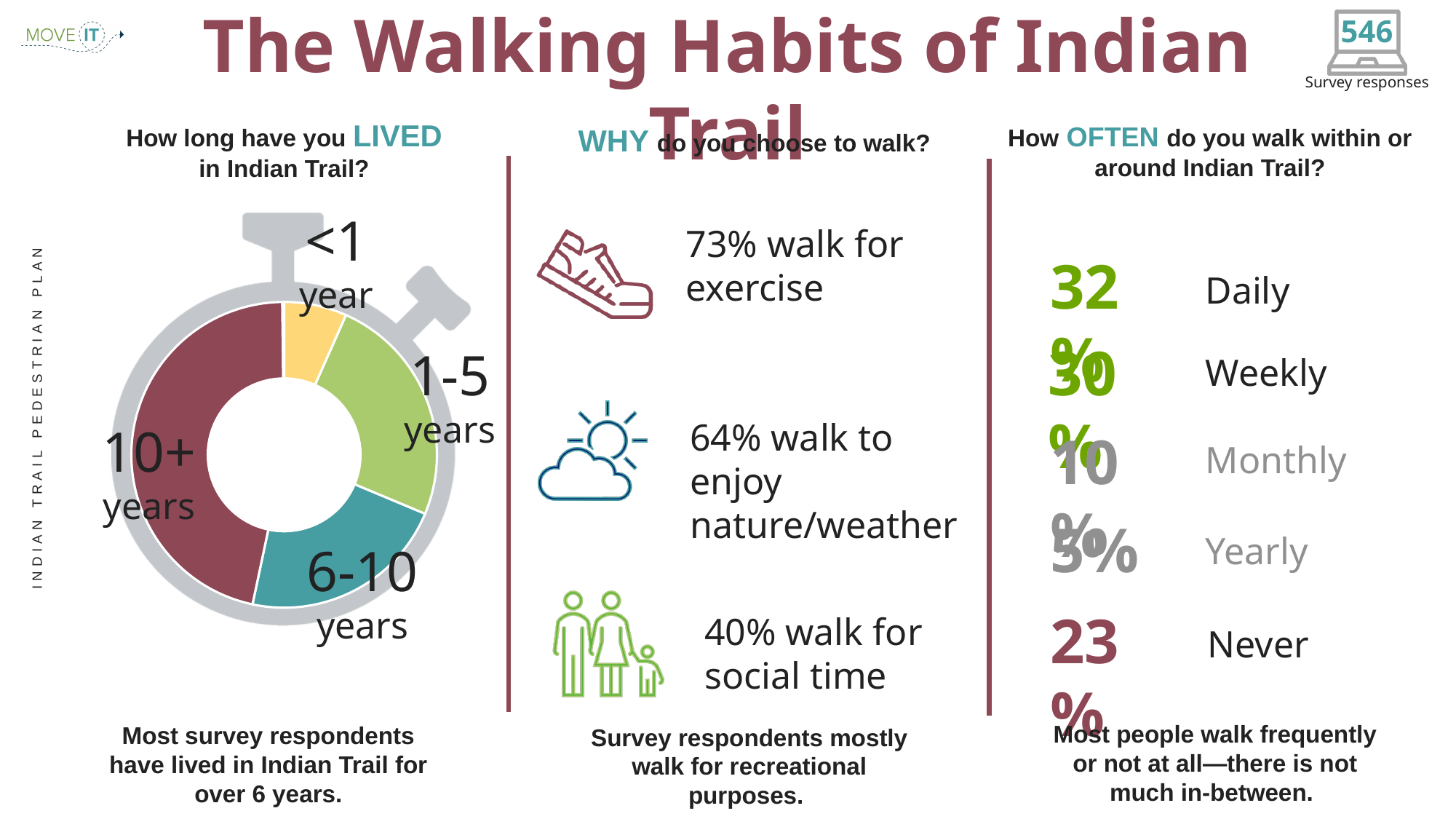
In the donut chart about how long respondents have lived in Indian Trail, which category has the smallest share? <1 year In the donut chart about how long respondents have lived in Indian Trail, which is larger: the share for 1-5 years or the share for 6-10 years? 1-5 years What colour is the 10+ years segment in the donut chart about how long respondents have lived in Indian Trail? Dark red (maroon) In the donut chart about how long respondents have lived in Indian Trail, which is larger: the share for 10+ years or the share for 1-5 years? 10+ years In the donut chart about how long respondents have lived in Indian Trail, which is larger: the share for 6-10 years or the share for <1 year? 6-10 years What kind of chart is shown under "How long have you LIVED in Indian Trail?"? Donut (pie) chart In the donut chart about how long respondents have lived in Indian Trail, which category has the largest share? 10+ years What question is the donut chart on the left of the slide answering? How long have you LIVED in Indian Trail? How many categories does the donut chart about how long respondents have lived in Indian Trail show? 4